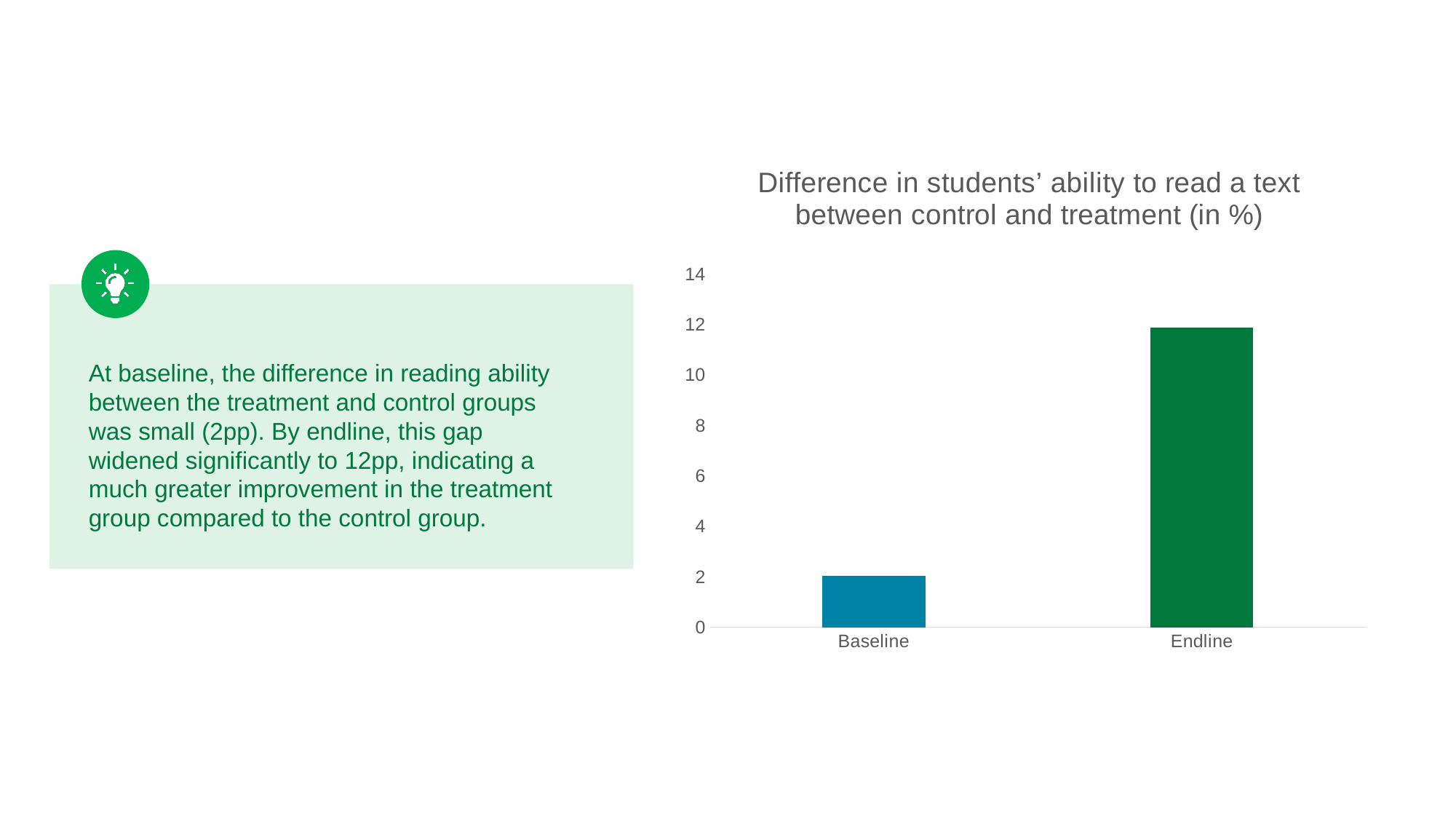
Is the value for Baseline greater or less than 4? less Is the value for Endline greater or less than 10? greater What is the title of the chart? Difference in students' ability to read a text between control and treatment (in %) Which category has the highest value? Endline What type of chart is shown on the slide? bar chart Do the values rise or fall from Baseline to Endline? rise How many categories are shown on the x axis? 2 Which is larger, the value for Baseline or the value for Endline? Endline Which category has the lowest value? Baseline